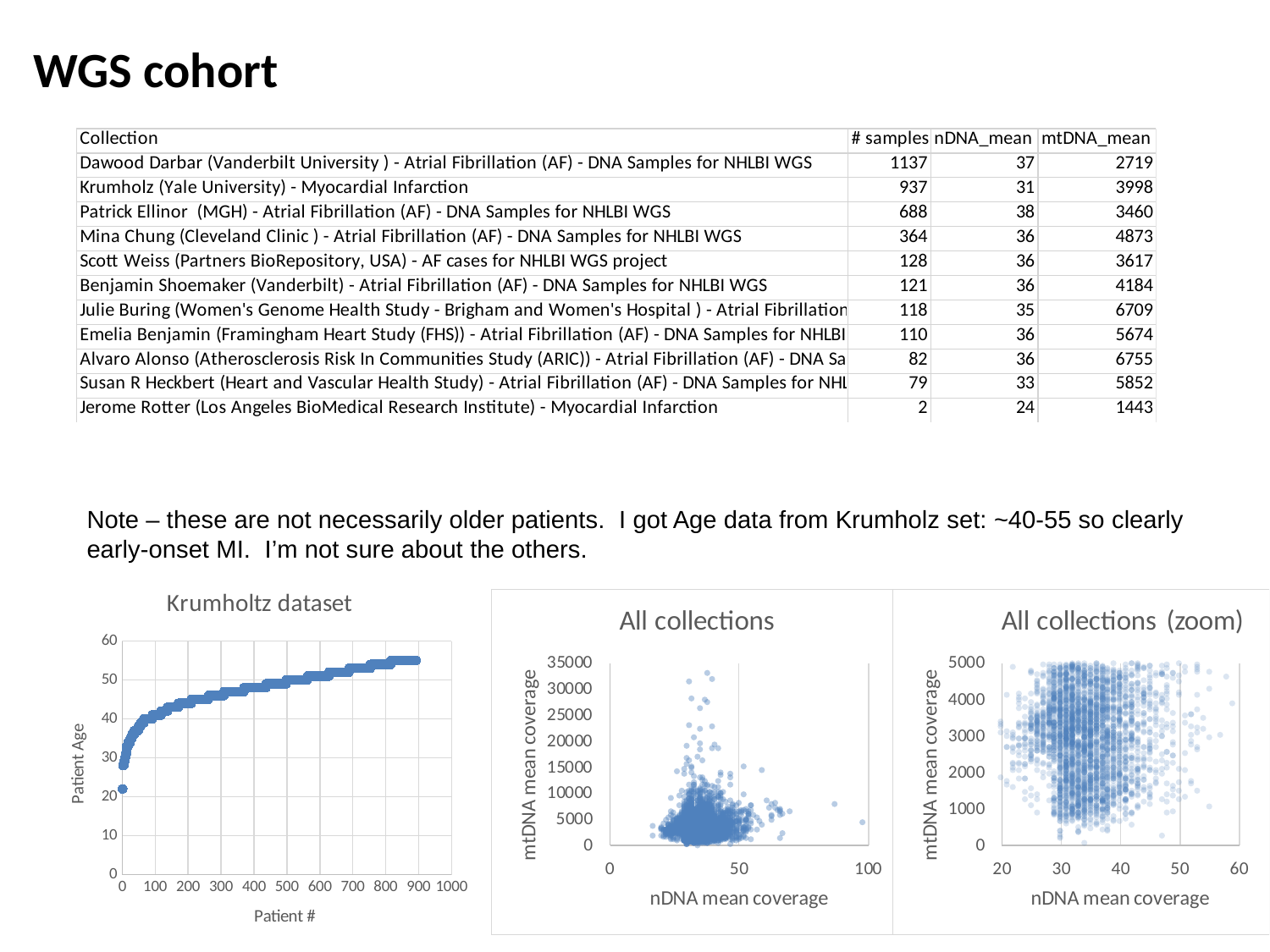
What is the label of the y axis in the "Krumholtz dataset" chart? Patient Age What kind of chart is the "Krumholtz dataset" chart? scatter plot What is the label of the x axis in the "All collections" chart? nDNA mean coverage In the "Krumholtz dataset" chart, do the patient age values rise or fall as the patient number increases? rise What is the highest tick value on the y axis of the "All collections" chart? 35000 What kind of chart is the "All collections" chart? scatter plot In the "Krumholtz dataset" chart, is the patient age of the first plotted patient (patient # near 0) greater or less than 30? less How many charts are shown on the slide? 3 What is the highest tick value on the x axis of the "All collections (zoom)" chart? 60 What is the highest tick value on the y axis of the "All collections (zoom)" chart? 5000 What is the highest tick value on the x axis of the "Krumholtz dataset" chart? 1000 In the "Krumholtz dataset" chart, is the patient age at patient # 900 greater or less than 50? greater